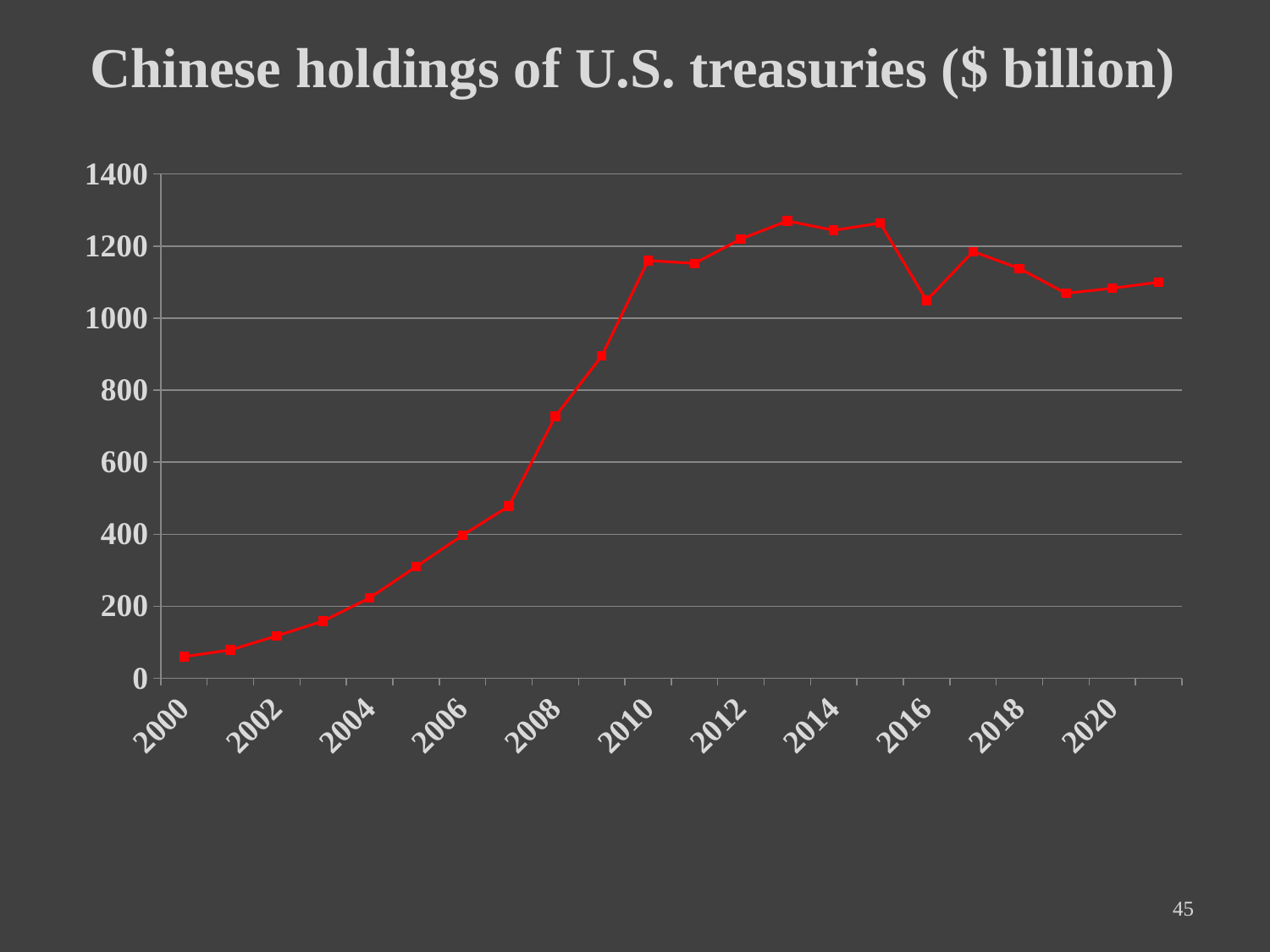
Is the value for 2016 greater or less than 1200? less Do the values rise or fall from 2000 to 2010? rise Is the value for 2007 greater or less than 400? greater Which is larger, the value for 2008 or the value for 2009? 2009 What is the title of the chart? Chinese holdings of U.S. treasuries ($ billion) What is the highest value shown on the vertical axis? 1400 Is the value for 2000 greater or less than 200? less Which year has the lowest value on the chart? 2000 What kind of chart is shown on the slide? line chart Which is larger, the value for 2016 or the value for 2017? 2017